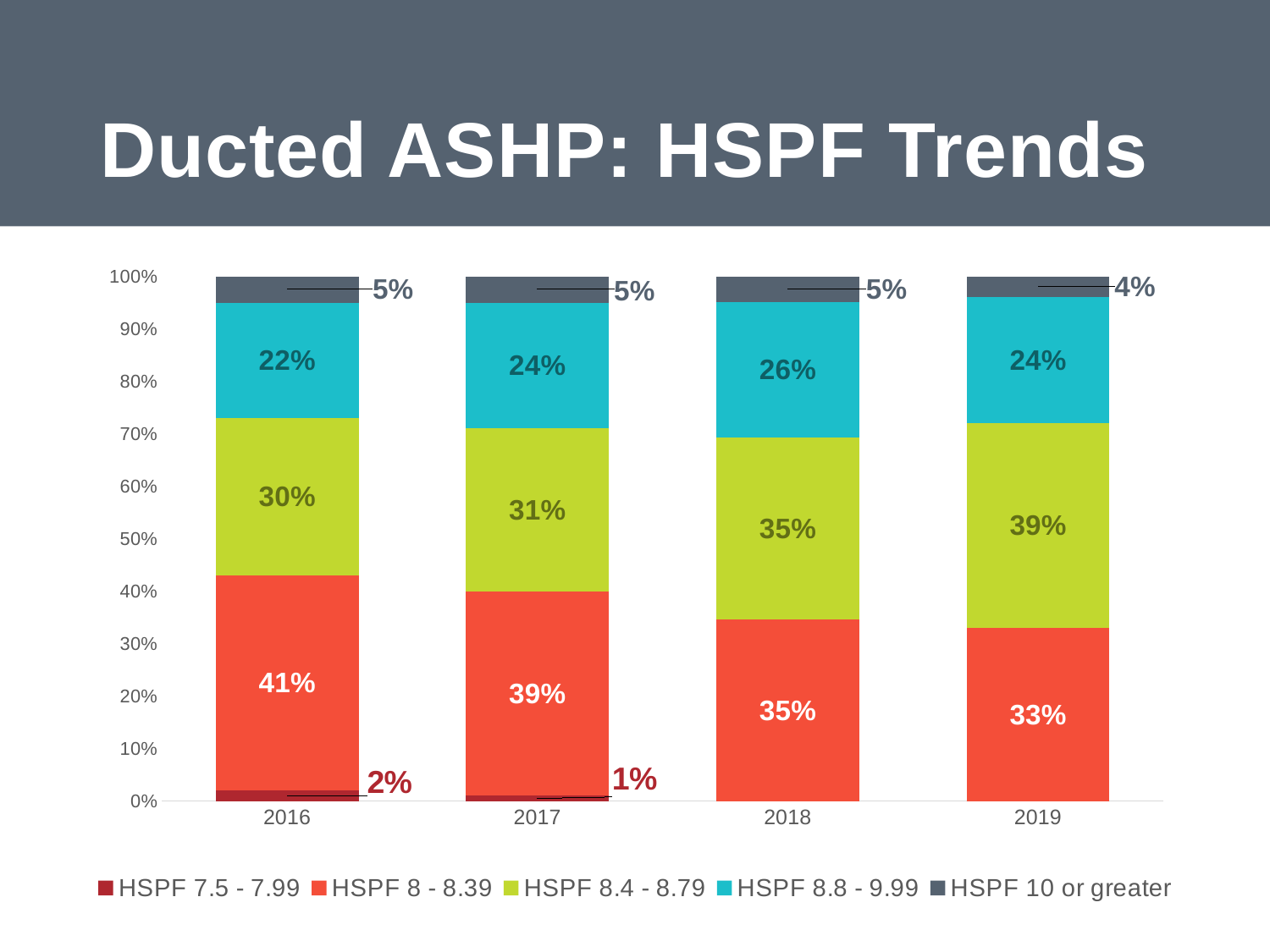
What is the difference between the HSPF 8 - 8.39 share in 2016 and in 2019? 8% What is the value for HSPF 8.8 - 9.99 in 2018? 26% What percentage of ducted ASHPs in 2016 had HSPF 8 - 8.39? 41% Is the HSPF 8.4 - 8.79 share larger in 2018 or in 2019? 2019 Does the share of HSPF 8 - 8.39 units rise or fall from 2016 to 2019? Fall What is the value for HSPF 10 or greater in 2019? 4% What is the value for HSPF 8.4 - 8.79 in 2019? 39% How many series does the legend list? 5 How many years are shown on the x axis? 4 What kind of chart is shown on the slide? Stacked bar chart Which year has the highest share of HSPF 8 - 8.39 units? 2016 Which year has the lowest share of HSPF 8.4 - 8.79 units? 2016